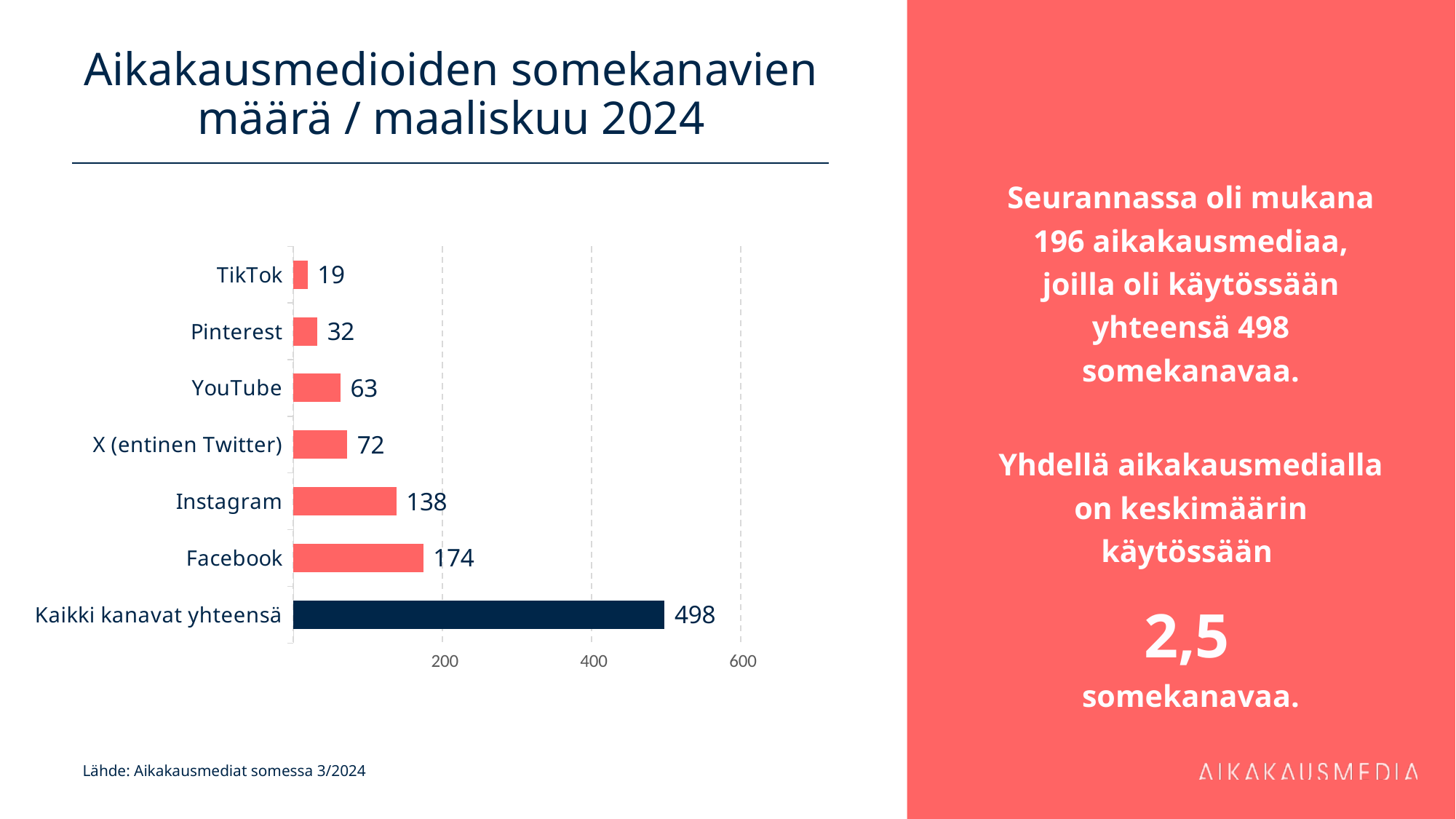
Which category has the lowest value? TikTok Which individual channel (excluding the total bar) has the highest value? Facebook What is the value for Kaikki kanavat yhteensä? 498 What is the difference between the values for X (entinen Twitter) and YouTube? 9 What is the value for Facebook? 174 What is the value for TikTok? 19 What kind of chart is shown on the slide? Bar chart Which is larger, the value for Pinterest or the value for YouTube? YouTube How many bars are shown in the chart? 7 Which bar is shown in a different colour (dark navy) from the others? Kaikki kanavat yhteensä What is the difference between the values for Facebook and Instagram? 36 What is the value for Instagram? 138